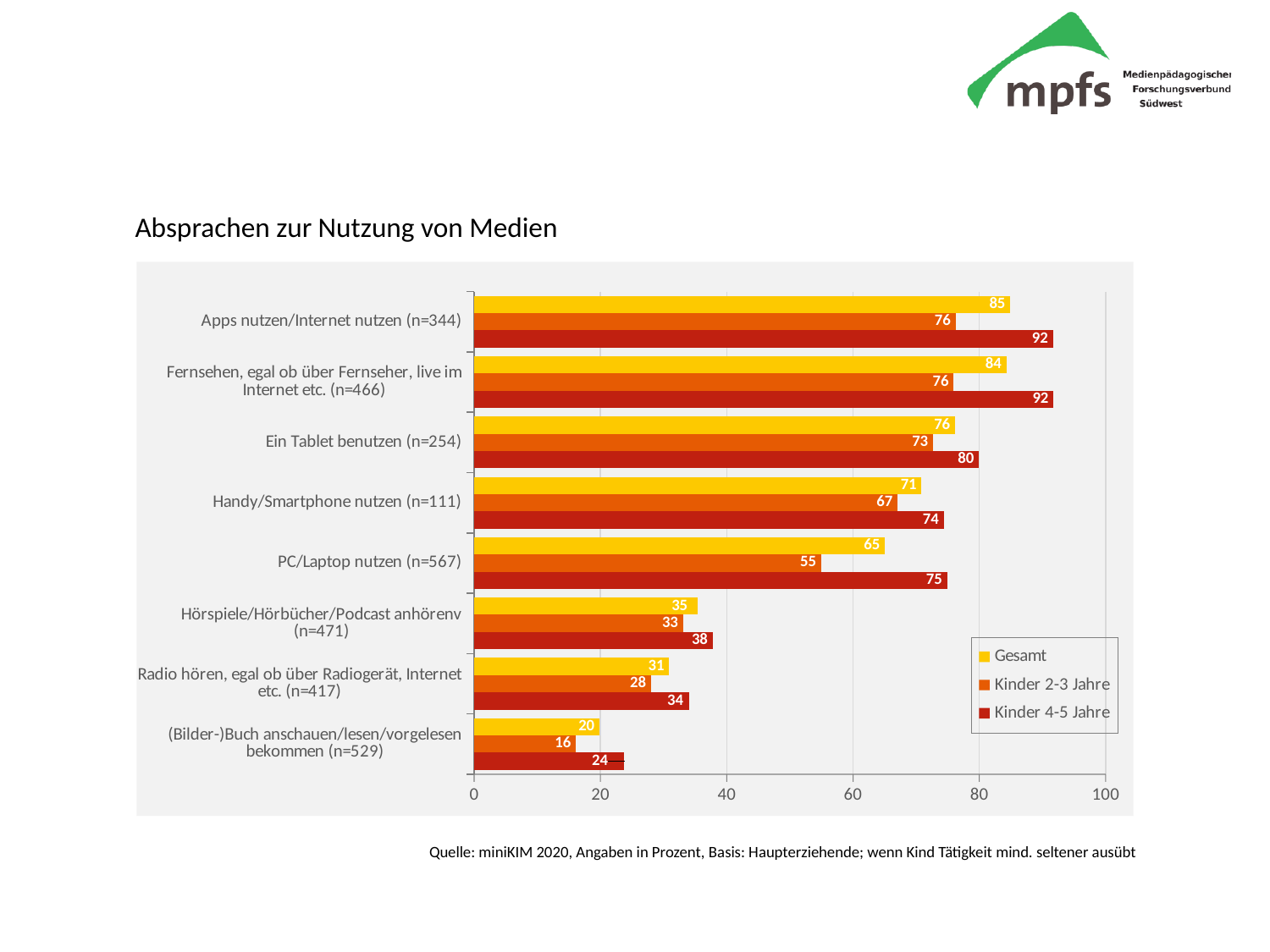
What is the Kinder 2-3 Jahre value for "PC/Laptop nutzen (n=567)"? 55 How many categories are shown on the chart? 8 What is the Gesamt value for "Apps nutzen/Internet nutzen (n=344)"? 85 What is the difference between the Kinder 4-5 Jahre and Kinder 2-3 Jahre values for "PC/Laptop nutzen (n=567)"? 20 What is the Kinder 4-5 Jahre value for "Ein Tablet benutzen (n=254)"? 80 Which is larger for "Handy/Smartphone nutzen (n=111)": the Gesamt value or the Kinder 2-3 Jahre value? Gesamt Which category has the lowest Gesamt value? (Bilder-)Buch anschauen/lesen/vorgelesen bekommen (n=529) What is the title of the chart? Absprachen zur Nutzung von Medien Which category has the highest Kinder 2-3 Jahre value? Apps nutzen/Internet nutzen (n=344) and Fernsehen, egal ob über Fernseher, live im Internet etc. (n=466) What kind of chart is shown on the slide? bar chart How many series does the legend list? 3 Which colour represents the Kinder 4-5 Jahre series? dark red